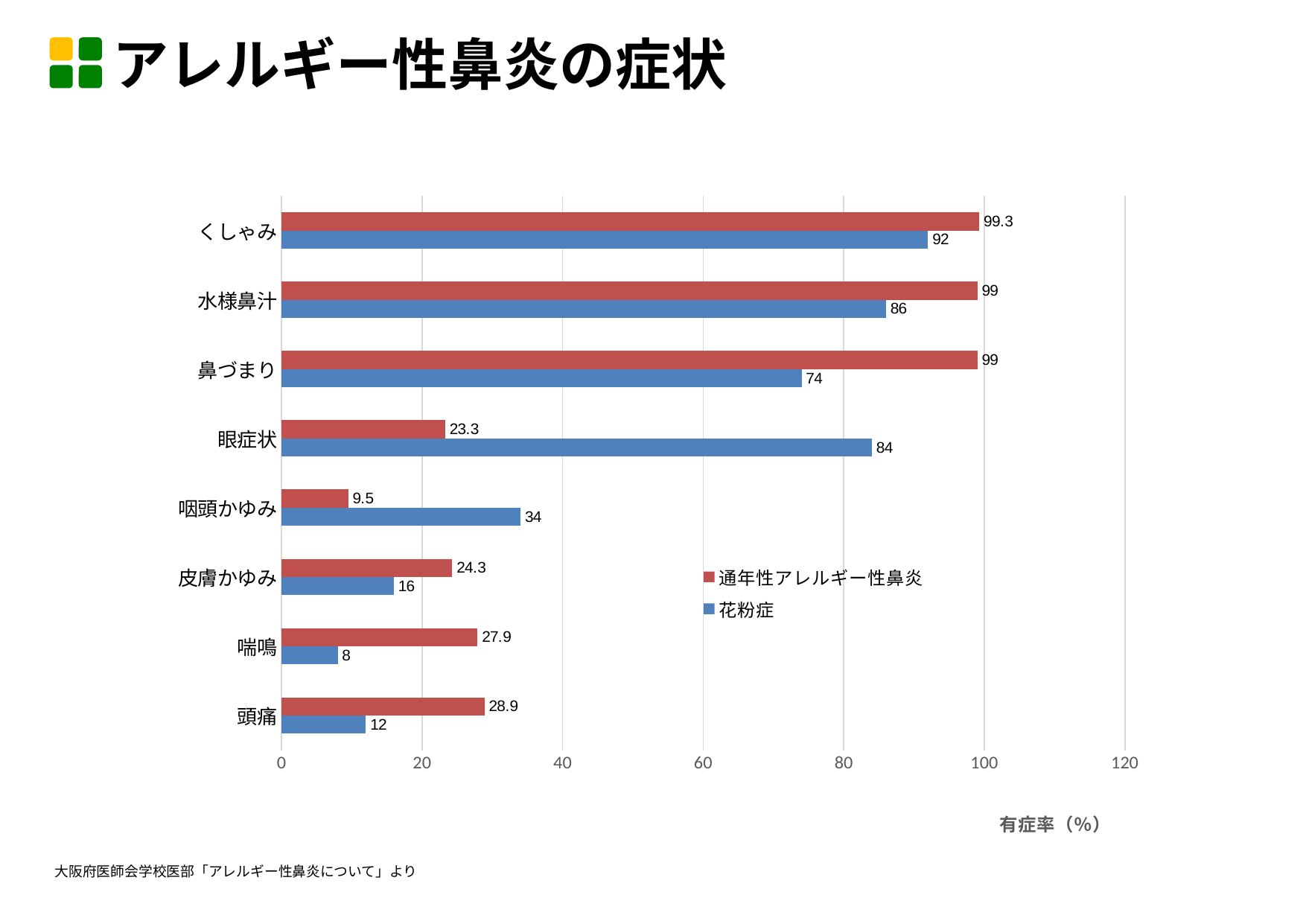
Which category has the highest value in the 花粉症 series? くしゃみ What is the difference between the 通年性アレルギー性鼻炎 and 花粉症 values for 鼻づまり? 25 What is the value for 眼症状 in the 花粉症 series? 84 What is the value for 喘鳴 in the 花粉症 series? 8 What is the label of the horizontal axis? 有症率（%） Is the 花粉症 value for 水様鼻汁 greater or less than 80? greater For 眼症状, which series has the larger value, 通年性アレルギー性鼻炎 or 花粉症? 花粉症 Which category has the lowest value in the 通年性アレルギー性鼻炎 series? 咽頭かゆみ How many symptom categories are shown on the chart? 8 What kind of chart is shown on the slide? bar chart What is the value for くしゃみ in the 通年性アレルギー性鼻炎 series? 99.3 How many series does the legend list? 2